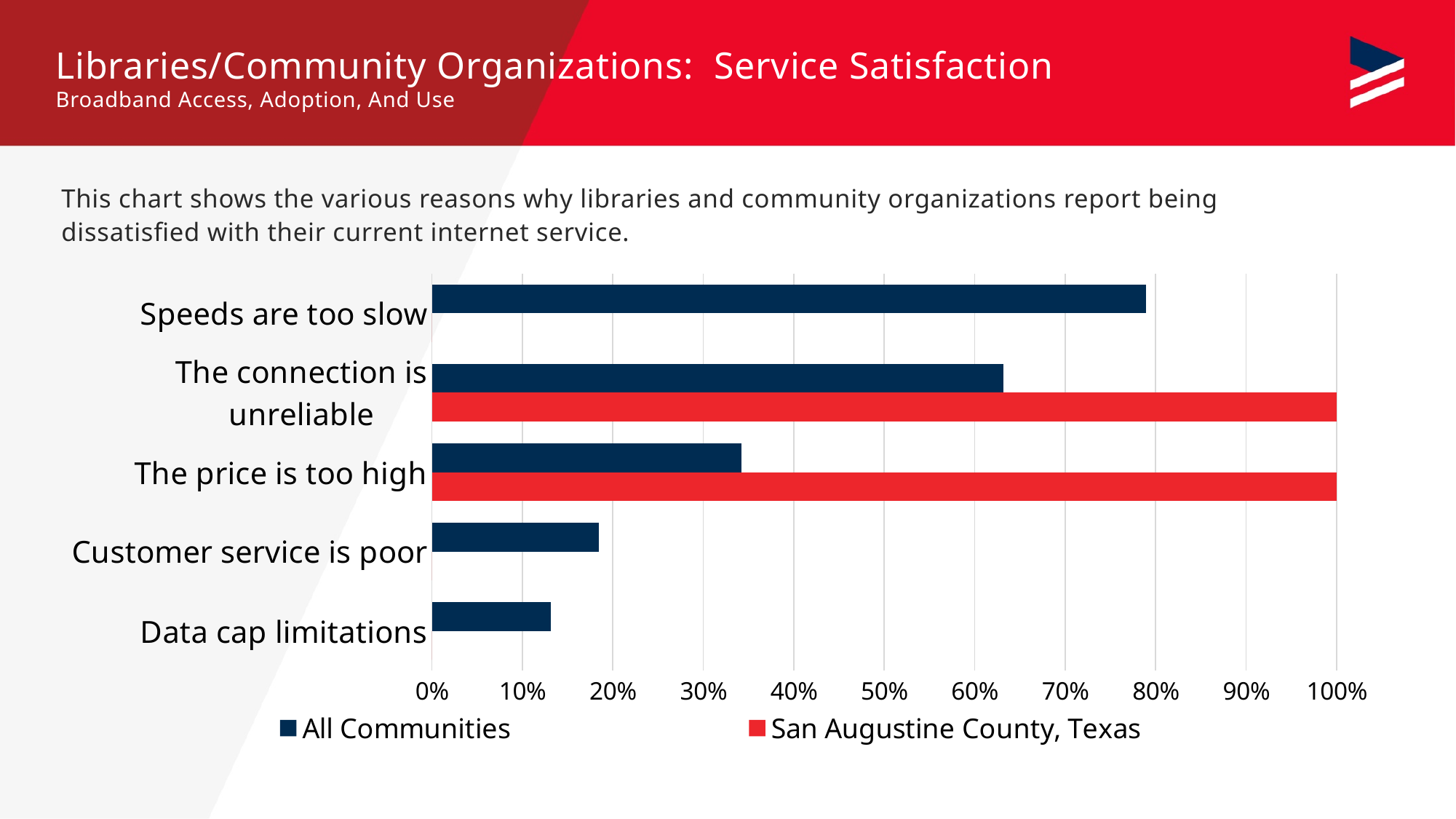
Which reason has the lowest value for All Communities? Data cap limitations What kind of chart is shown on the slide? bar chart Is the All Communities value for 'The price is too high' greater or less than 40%? less How many series does the legend list? 2 Which series is shown in red in the legend? San Augustine County, Texas What is the value for San Augustine County, Texas for 'The price is too high'? 100% For 'The connection is unreliable', which series has the larger value: All Communities or San Augustine County, Texas? San Augustine County, Texas How many reasons (categories) are listed on the chart? 5 What is the value for San Augustine County, Texas for 'The connection is unreliable'? 100% Is the All Communities value for 'Speeds are too slow' greater or less than 70%? greater Which reason has the highest value for All Communities? Speeds are too slow Is the All Communities value for 'Customer service is poor' greater or less than 20%? less